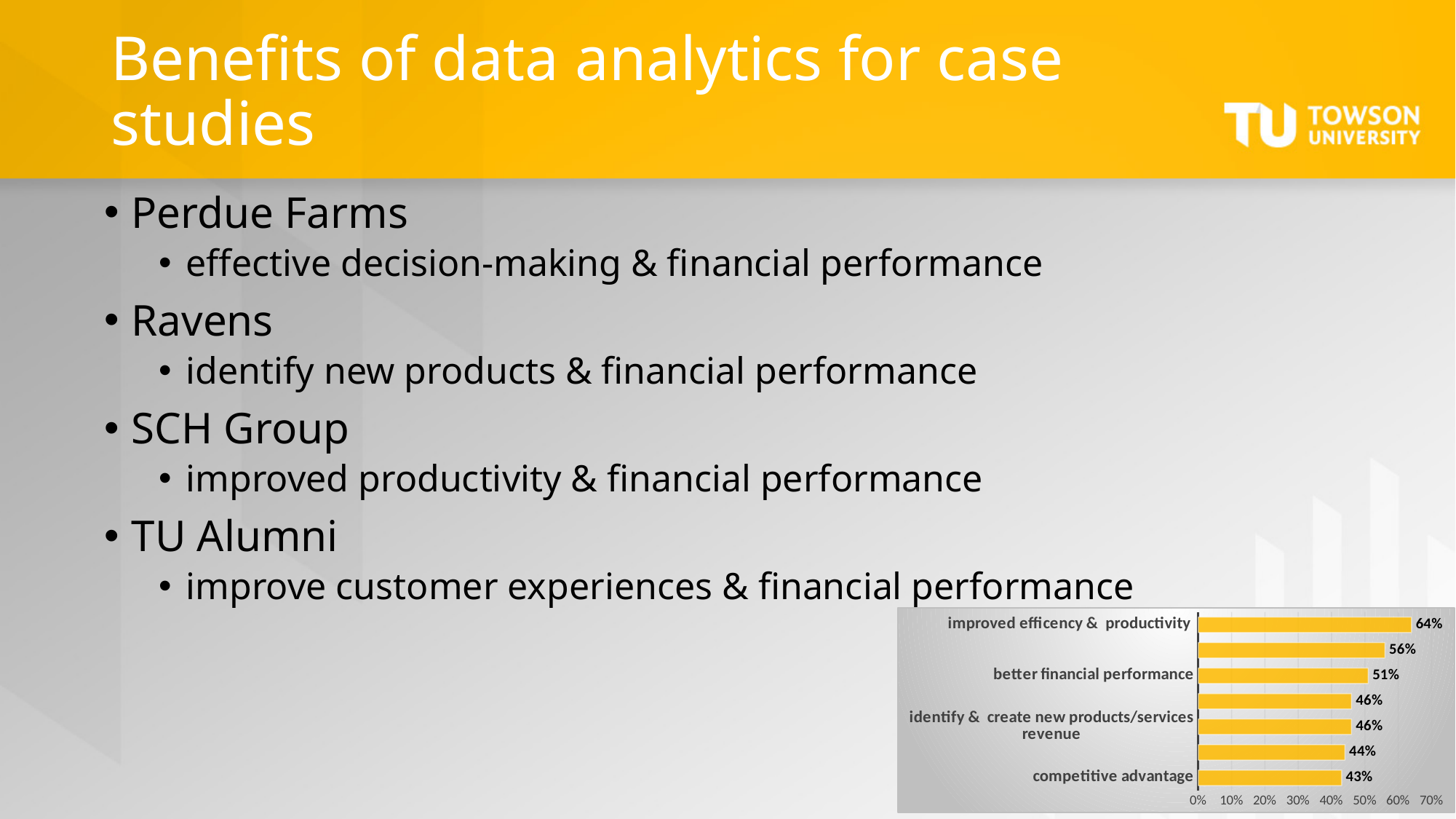
What is the difference between the values for 'better financial performance' and 'identify & create new products/services revenue'? 5 percentage points What is the value for 'competitive advantage'? 43% What is the highest value shown on the chart's horizontal axis? 70% What kind of chart is shown on the slide? bar chart Which category has the highest value? improved efficency & productivity What is the value for 'improved efficency & productivity'? 64% Which is larger, the value for 'better financial performance' or the value for 'competitive advantage'? better financial performance Which category has the lowest value? competitive advantage What is the value for 'better financial performance'? 51% What is the difference between the values for 'improved efficency & productivity' and 'competitive advantage'? 21 percentage points How many bars are plotted in the chart? 7 What is the value for 'identify & create new products/services revenue'? 46%